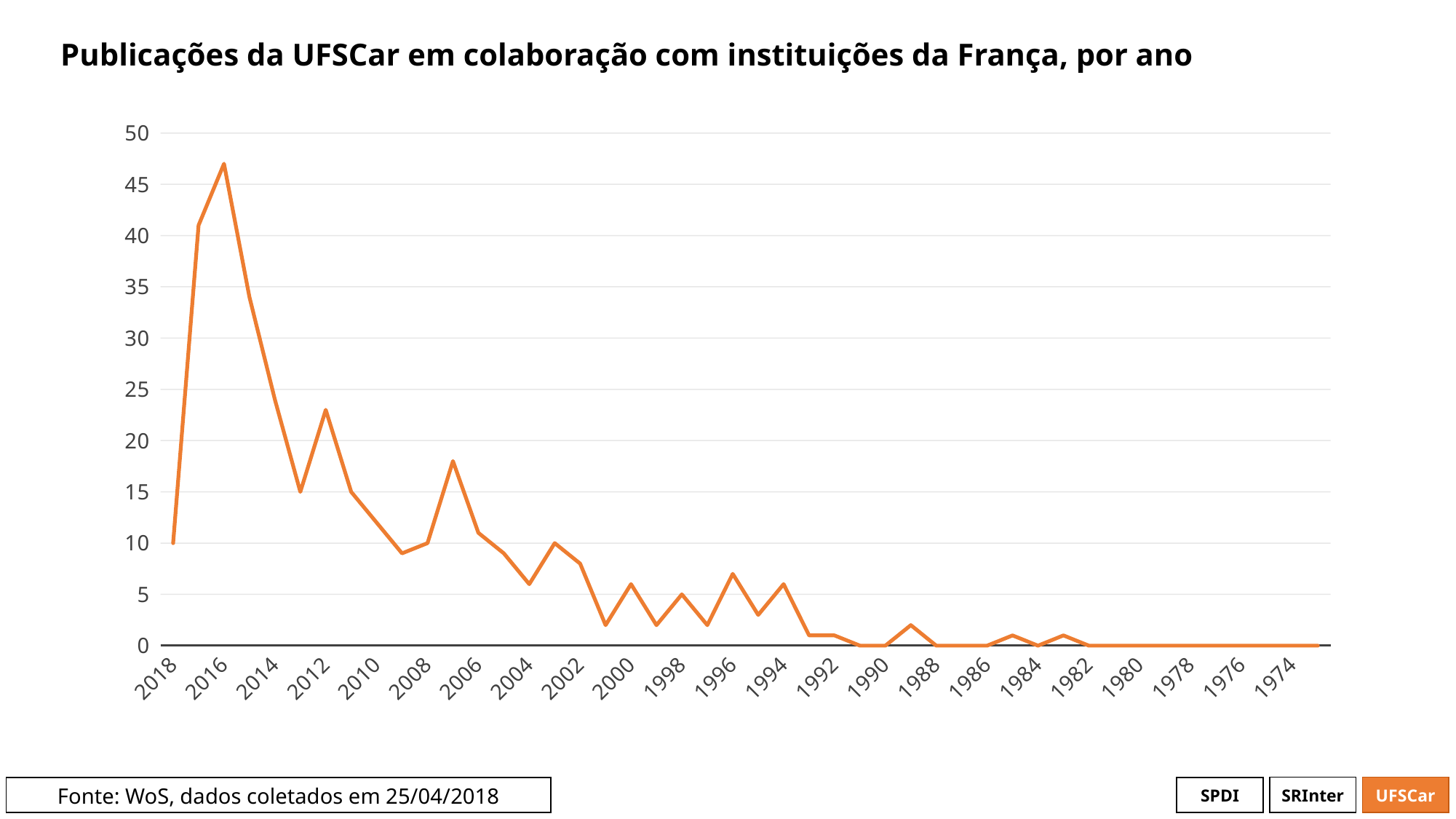
What is the title of the chart? Publicações da UFSCar em colaboração com instituições da França, por ano Is the value for 2007 greater or less than 15? greater Moving from left to right along the x axis (from 2018 toward 1974), do the values generally rise or fall? fall What is the value for 1998? 5 Is the value for 2017 greater or less than 40? greater Which year has the highest number of publications? 2016 What is the value for 1990? 0 What is the value for 2008? 10 What is the value for 2018? 10 Which year has the larger value, 2016 or 2012? 2016 What type of chart is shown on the slide? line chart Is the value for 2012 greater or less than 20? greater